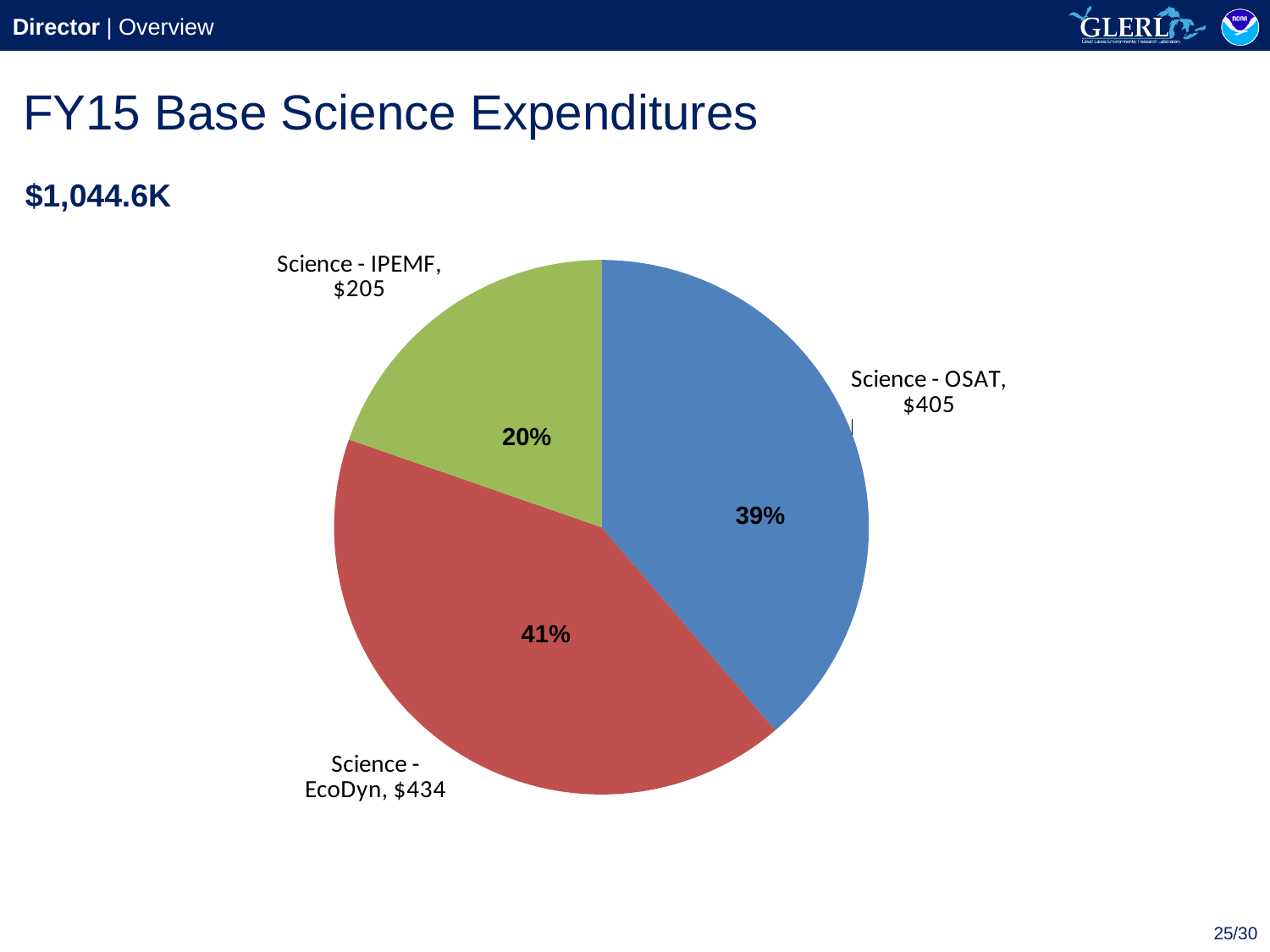
Which category has the smallest slice? Science - IPEMF What share of the pie does Science - IPEMF represent? 20% What is the title of the chart? FY15 Base Science Expenditures What is the value for Science - EcoDyn? $434 What is the value for Science - OSAT? $405 What kind of chart is shown on the slide? pie chart Which is larger, the value for Science - OSAT or Science - IPEMF? Science - OSAT How many slices does the pie chart have? 3 Which category has the largest slice? Science - EcoDyn What share of the pie does Science - OSAT represent? 39% What is the difference between the values for Science - EcoDyn and Science - IPEMF? $229 What is the value for Science - IPEMF? $205